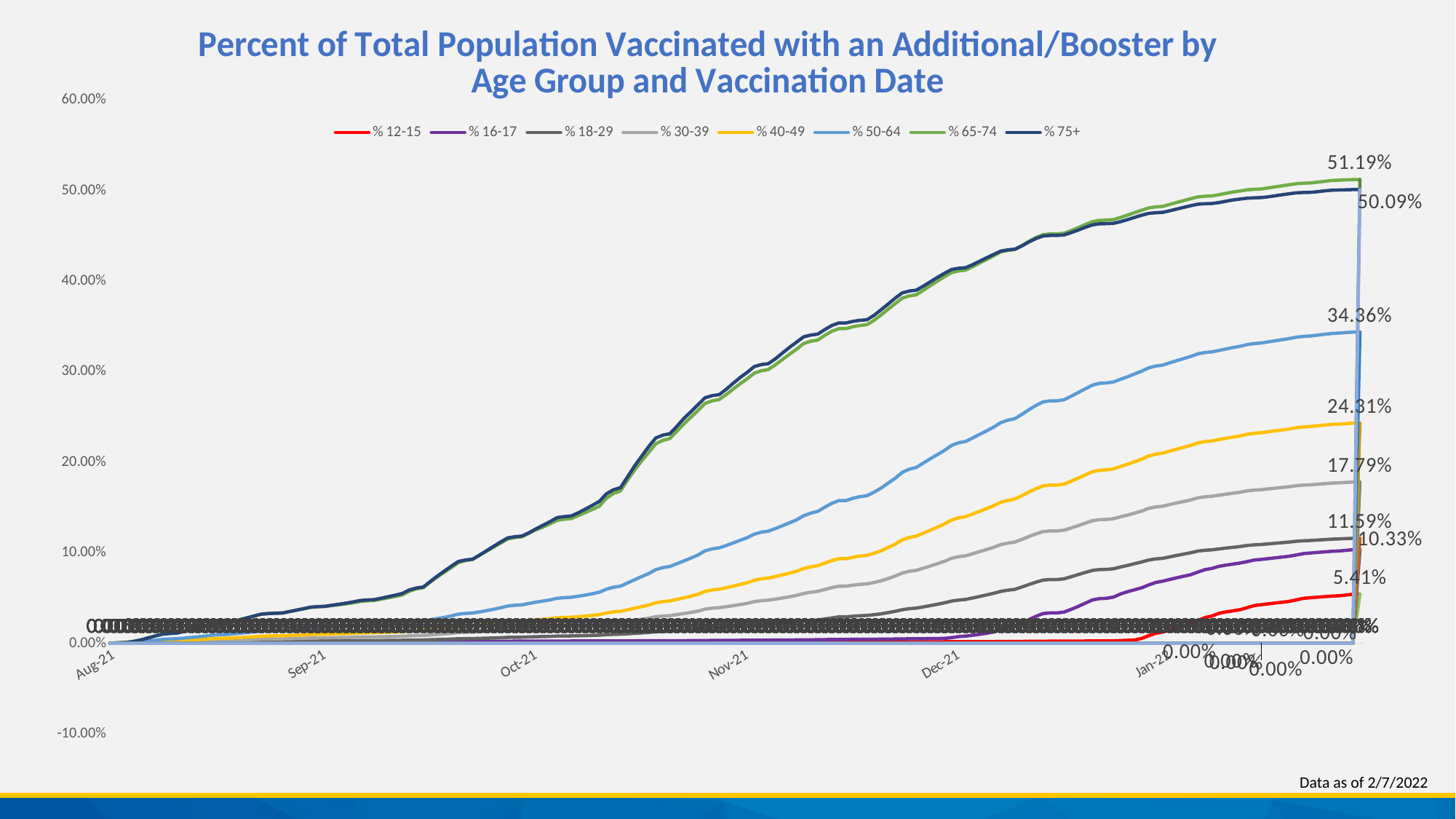
Which has a higher final value, the % 30-39 series or the % 18-29 series? % 30-39 Which age group has the lowest final value on the chart? % 12-15 Which age group has the highest final value on the chart? % 65-74 What is the final labeled value for the % 12-15 series? 5.41% What is the final labeled value for the % 65-74 series? 51.19% What kind of chart is shown on the slide? line chart What is the title of the chart? Percent of Total Population Vaccinated with an Additional/Booster by Age Group and Vaccination Date How many series does the legend list? 8 What is the difference between the final values of the % 65-74 series (51.19%) and the % 75+ series (50.09%)? 1.10% What is the final labeled value for the % 50-64 series? 34.36% What is the final labeled value for the % 40-49 series? 24.31% Do the values for the % 50-64 series rise or fall from Aug-21 to Jan-22? rise